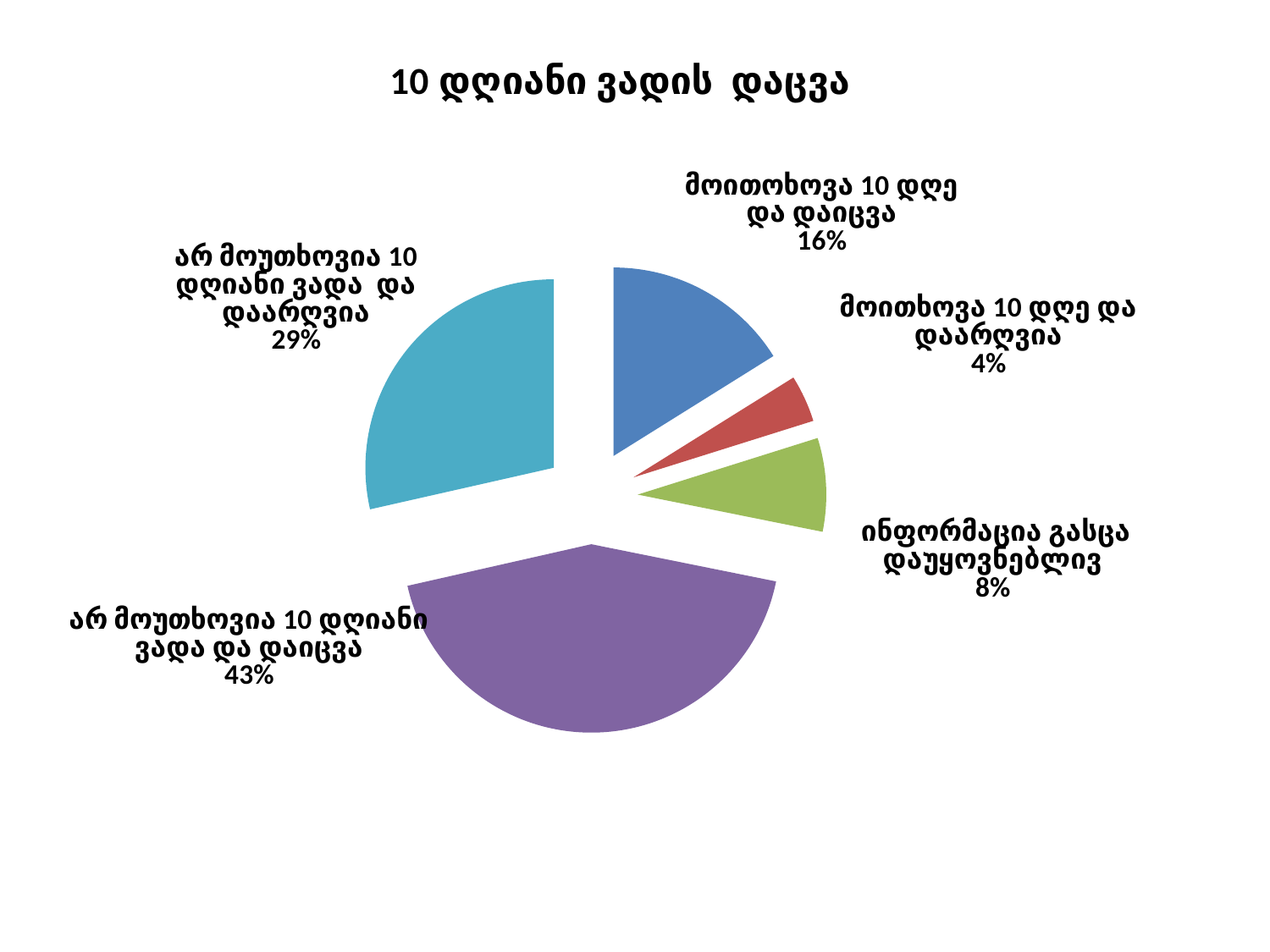
Which slice of the pie is the largest? არ მოუთხოვია 10 დღიანი ვადა და დაიცვა What kind of chart is shown on the slide? pie chart What share of the pie is labelled "მოითხოვა 10 დღე და დაიცვა"? 16% Which slice of the pie is the smallest? მოითხოვა 10 დღე და დაარღვია What is the difference in percentage points between "არ მოუთხოვია 10 დღიანი ვადა და დაიცვა" and "არ მოუთხოვია 10 დღიანი ვადა და დაარღვია"? 14% What share of the pie is labelled "არ მოუთხოვია 10 დღიანი ვადა და დაიცვა"? 43% What share of the pie is labelled "ინფორმაცია გასცა დაუყოვნებლივ"? 8% Which is larger: the share for "მოითხოვა 10 დღე და დაიცვა" or the share for "ინფორმაცია გასცა დაუყოვნებლივ"? მოითხოვა 10 დღე და დაიცვა What is the title of the chart? 10 დღიანი ვადის დაცვა How many slices does the pie chart have? 5